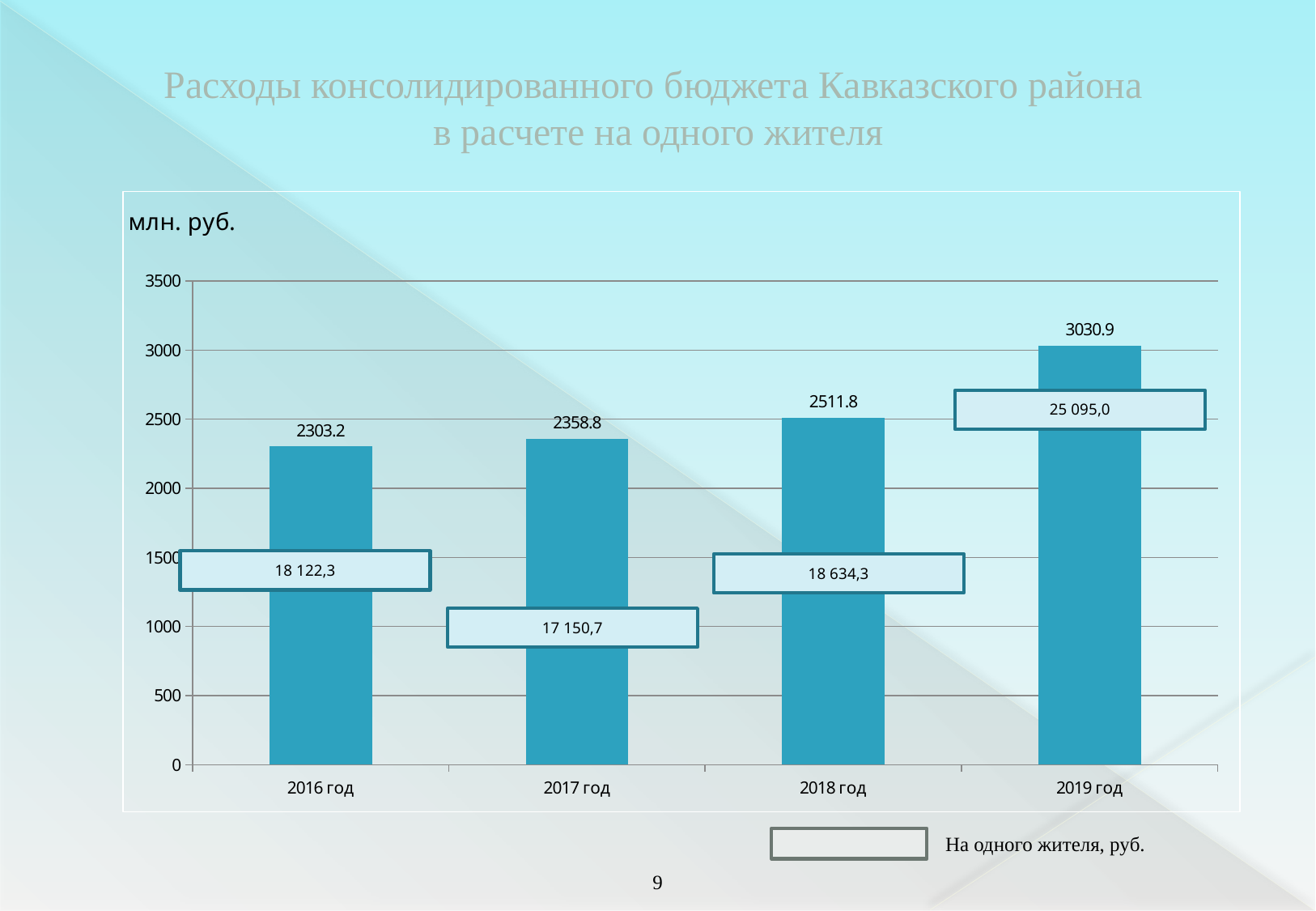
What kind of chart is shown on the slide? bar chart Which year has the lowest bar? 2016 год Which is larger, the bar value for 2017 год or for 2018 год? 2018 год What is the per-resident value (На одного жителя, руб.) shown for 2017 год? 17 150,7 Which year has the highest bar? 2019 год What is the difference between the bar values for 2019 год and 2018 год? 519.1 Do the bar values rise or fall from 2016 год to 2019 год? rise What is the per-resident value (На одного жителя, руб.) shown for 2019 год? 25 095,0 What is the value of the bar for 2016 год? 2303.2 Is the value for 2019 год greater or less than 3000? greater What is the value of the bar for 2019 год? 3030.9 How many years are shown on the x axis? 4